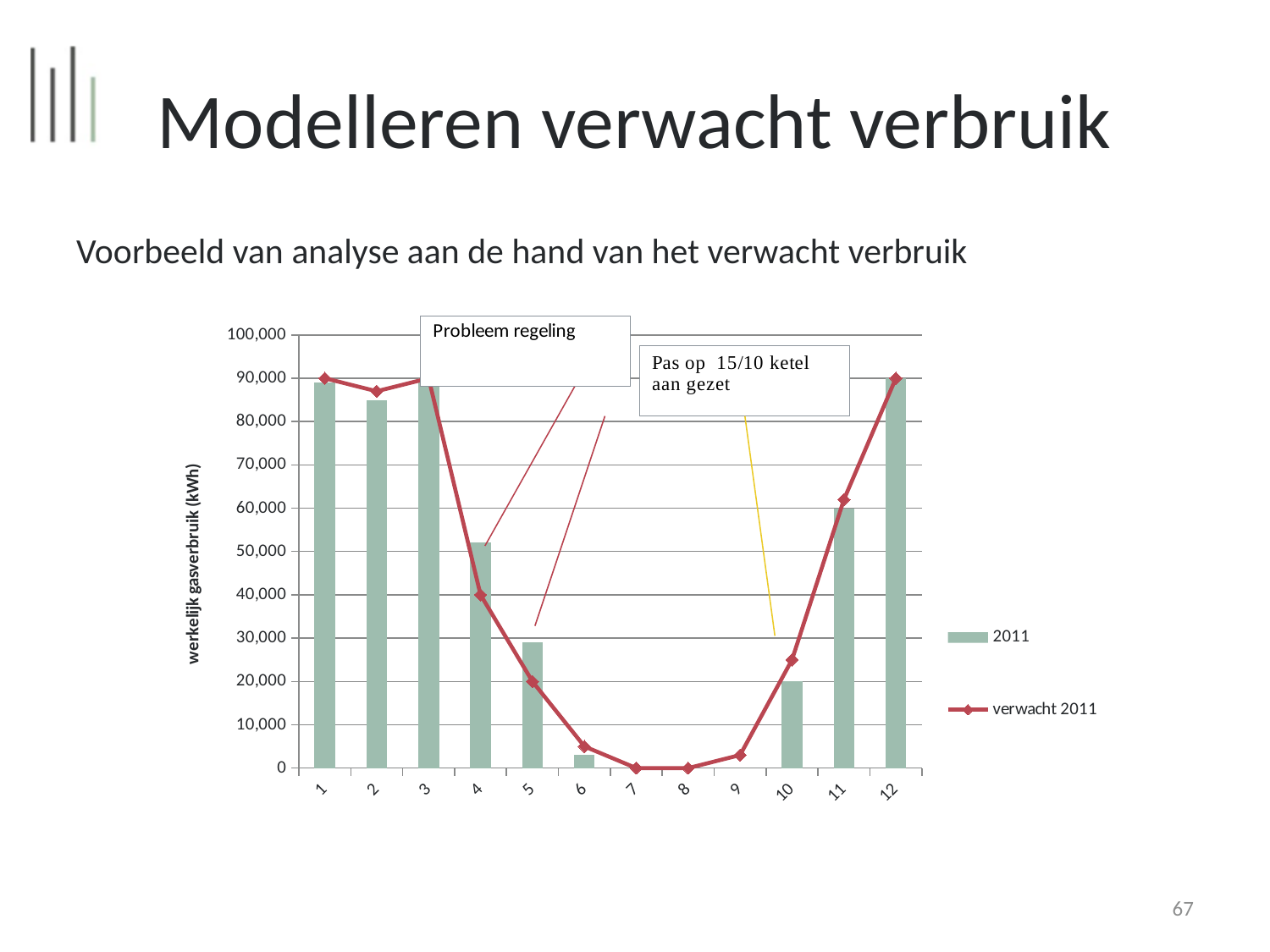
What is the title of the vertical axis? werkelijk gasverbruik (kWh) For category 4, which is larger: the 2011 bar or the verwacht 2011 line value? 2011 bar Is the verwacht 2011 value for category 6 greater or less than 10,000? less Is the 2011 bar for category 4 greater or less than 40,000? greater Is the 2011 bar for category 5 greater or less than 40,000? less For category 10, which is larger: the 2011 bar or the verwacht 2011 line value? verwacht 2011 What kind of chart is shown on the slide? A combined bar and line chart Which series is drawn as a line with diamond markers? verwacht 2011 How many series does the legend list? 2 How many categories are shown on the x axis? 12 Does the verwacht 2011 line rise or fall from category 1 to category 7? fall